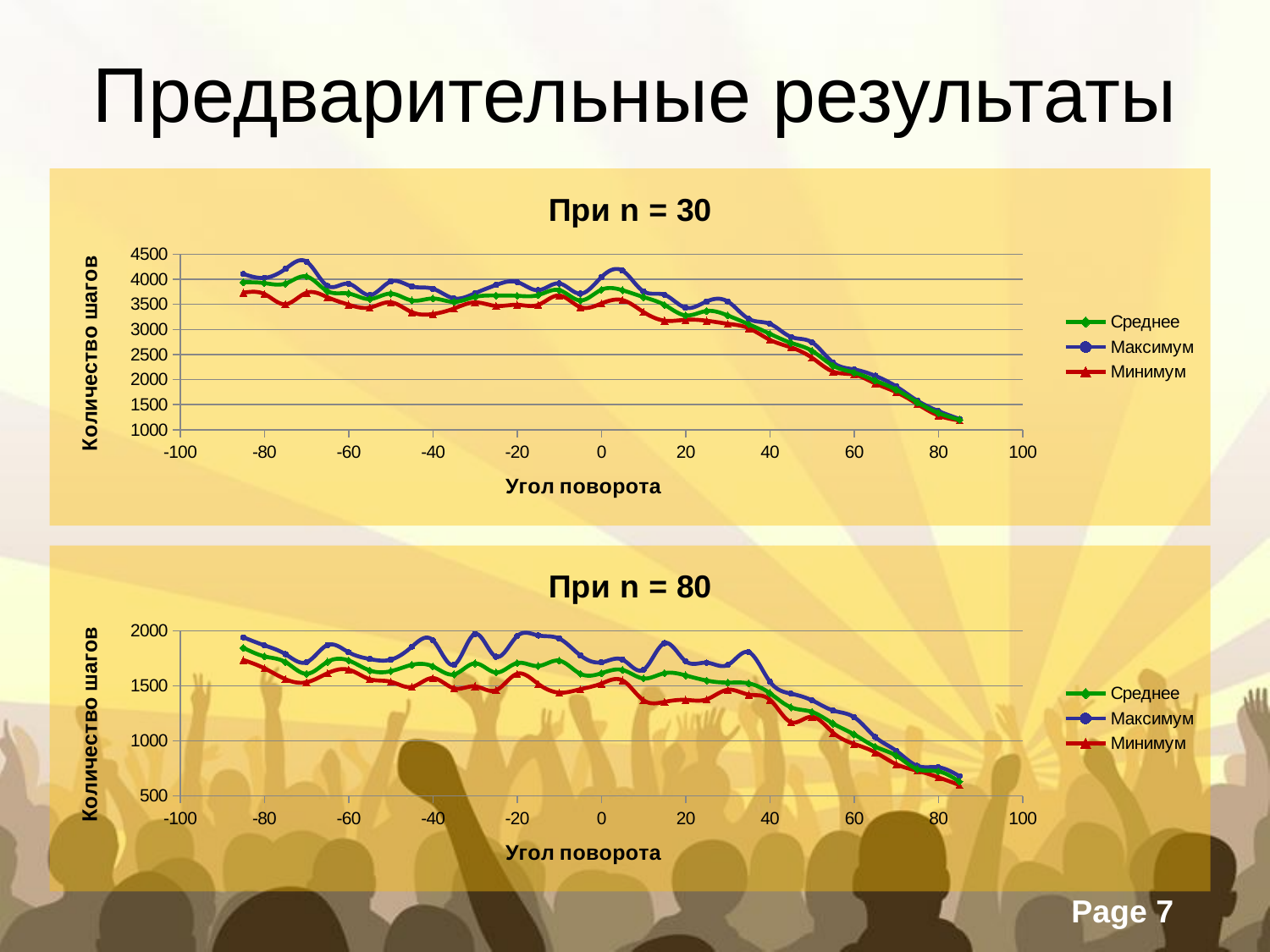
In the chart titled "При n = 80", is the value of Максимум at angle -15 greater or less than 1500? greater What is the label of the vertical axis in the chart titled "При n = 30"? Количество шагов In the chart titled "При n = 80", do the values generally rise or fall as the angle (Угол поворота) increases from -80 to 80? fall In the chart titled "При n = 30", is the value of Максимум at angle 85 greater or less than 1500? less In the chart titled "При n = 30", do the values generally rise or fall as the angle (Угол поворота) increases from -80 to 80? fall In the chart titled "При n = 30", is the value of Минимум at angle -40 greater or less than 3500? less What kind of chart is the chart titled "При n = 30"? line chart In the chart titled "При n = 80", which series has the larger value at angle 15, Максимум or Минимум? Максимум In the chart titled "При n = 30", which series has the larger value at angle -70, Максимум or Минимум? Максимум How many series does the legend of the chart titled "При n = 80" list? 3 Which series is drawn in red in the chart titled "При n = 80"? Минимум